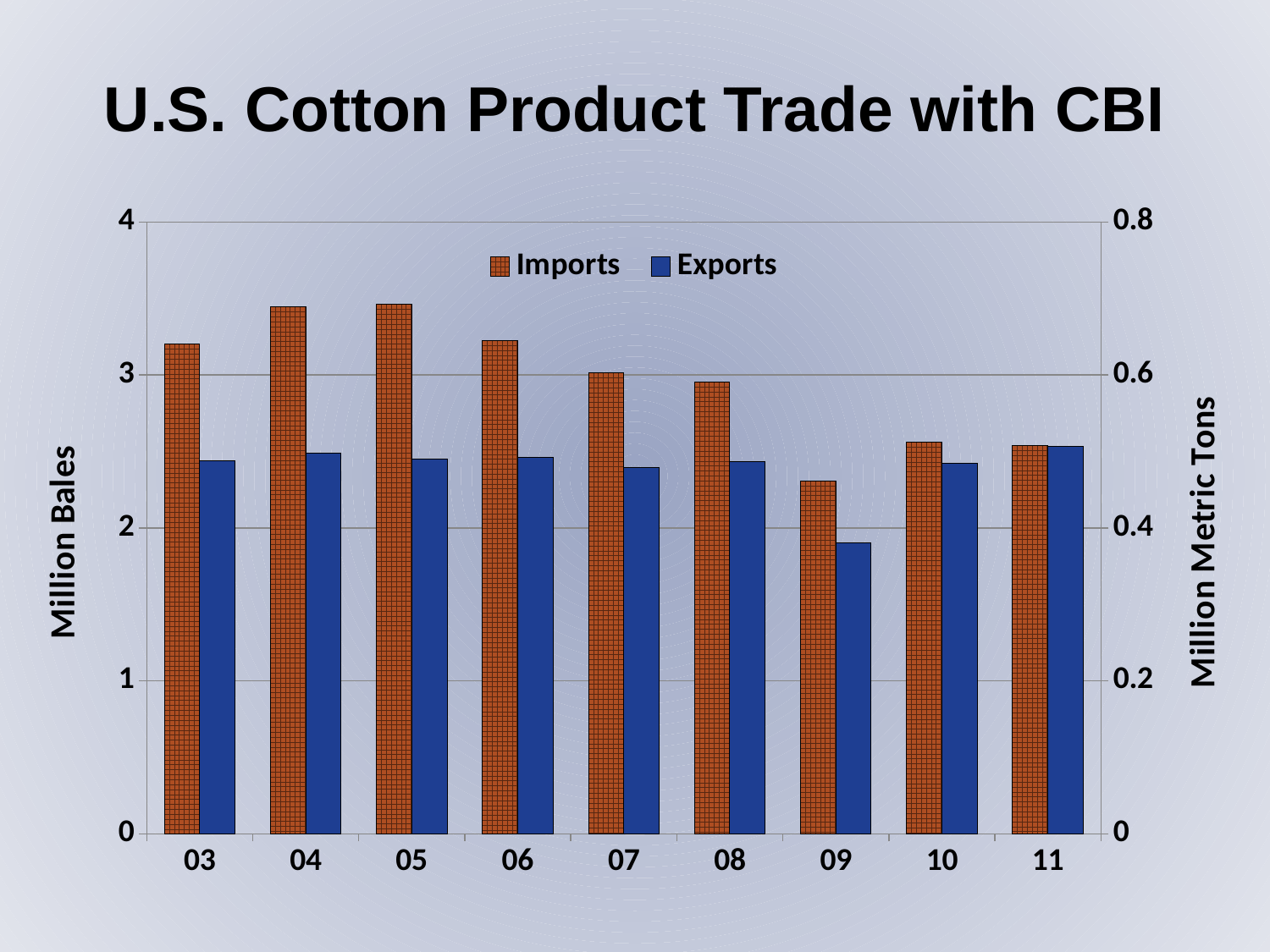
Is the Exports value for 07 greater or less than 3 million bales? less What kind of chart is shown on the slide? bar chart Is the Imports value for 09 greater or less than 2 million bales? greater In 03, which is larger, Imports or Exports? Imports Do the Imports values rise or fall from 05 to 09? fall Which year has the lowest Imports value? 09 Is the Exports value for 09 greater or less than 2 million bales? less How many series does the legend list? 2 How many years are shown on the x axis? 9 Which year has the lowest Exports value? 09 What is the label on the right-hand vertical axis? Million Metric Tons